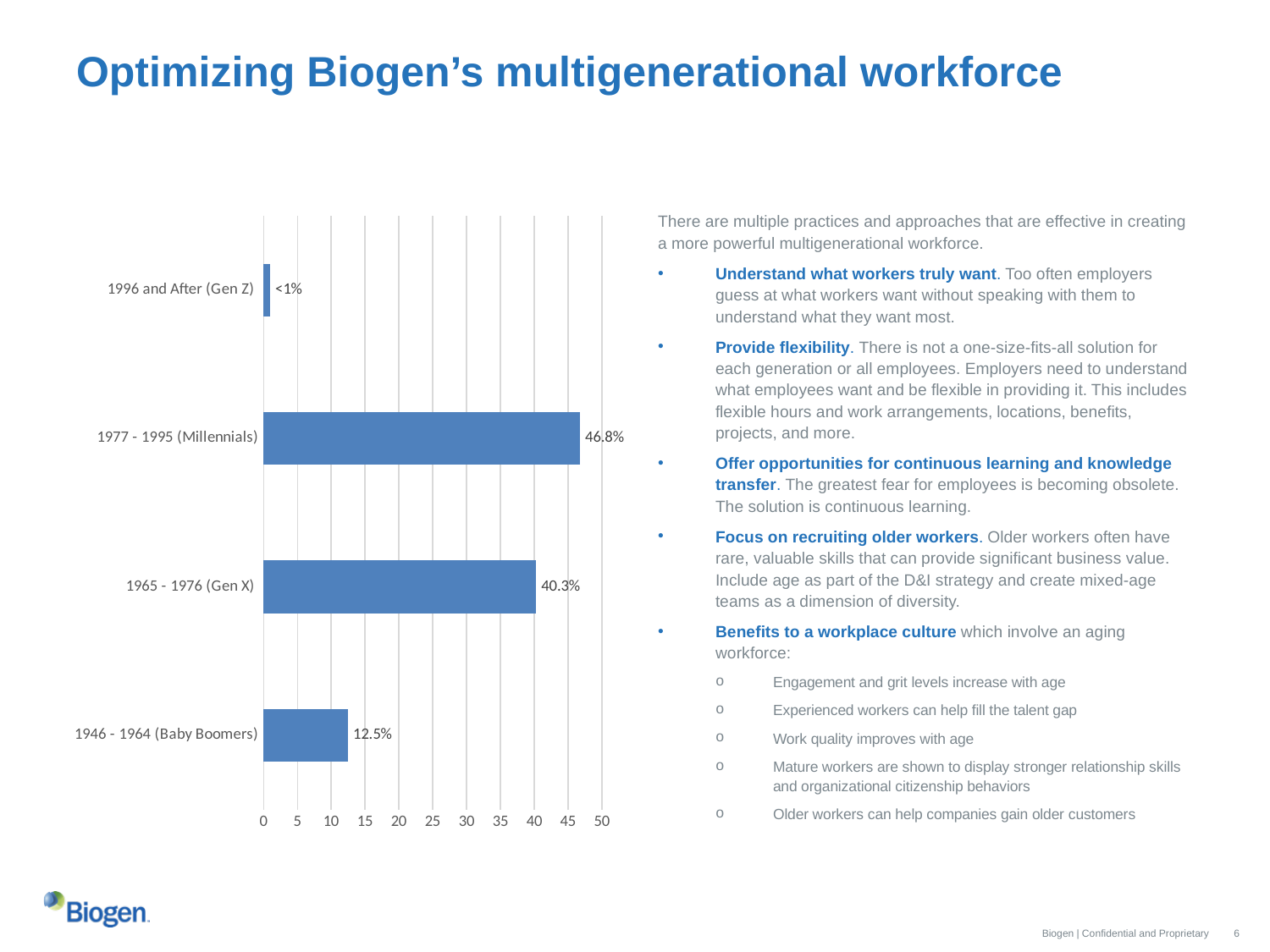
How many generation categories are shown in the chart? 4 Which generation has the lowest value? 1996 and After (Gen Z) What is the value for 1977 - 1995 (Millennials)? 46.8% What is the difference between the values for Millennials and Gen X? 6.5% Which is larger, the value for Gen X or the value for Baby Boomers? Gen X Which generation has the highest value? 1977 - 1995 (Millennials) What is the difference between the values for Gen X and Baby Boomers? 27.8% What is the value for 1946 - 1964 (Baby Boomers)? 12.5% What is the data label shown for 1996 and After (Gen Z)? <1% What is the value for 1965 - 1976 (Gen X)? 40.3% What kind of chart is shown on the slide? bar chart Is the value for 1977 - 1995 (Millennials) greater or less than 45? greater